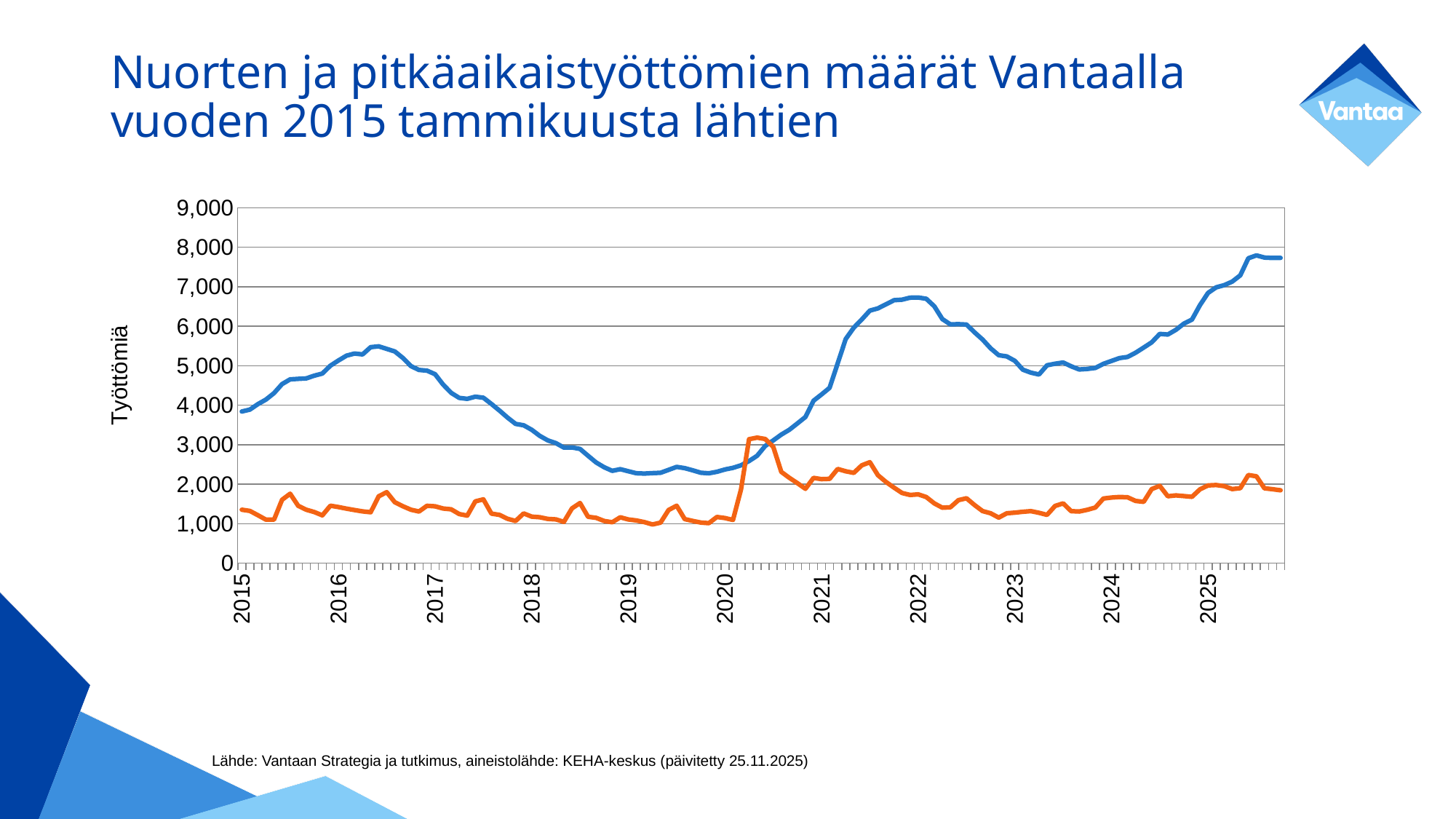
Is the value of the blue line at its last point in 2025 greater or less than 7,000? greater How many lines are plotted on the chart? 2 In which year does the orange line reach its highest value? 2020 Is the value of the blue line at the start of 2019 greater or less than 3,000? less Does the blue line rise or fall between 2016 and 2019? fall What is the title of the vertical axis? Työttömiä Is the peak value of the orange line in 2020 greater or less than 3,000? greater What is the highest value shown on the vertical axis? 9,000 What kind of chart is shown on the slide? line chart At the start of 2022, which line has the higher value, the blue line or the orange line? the blue line